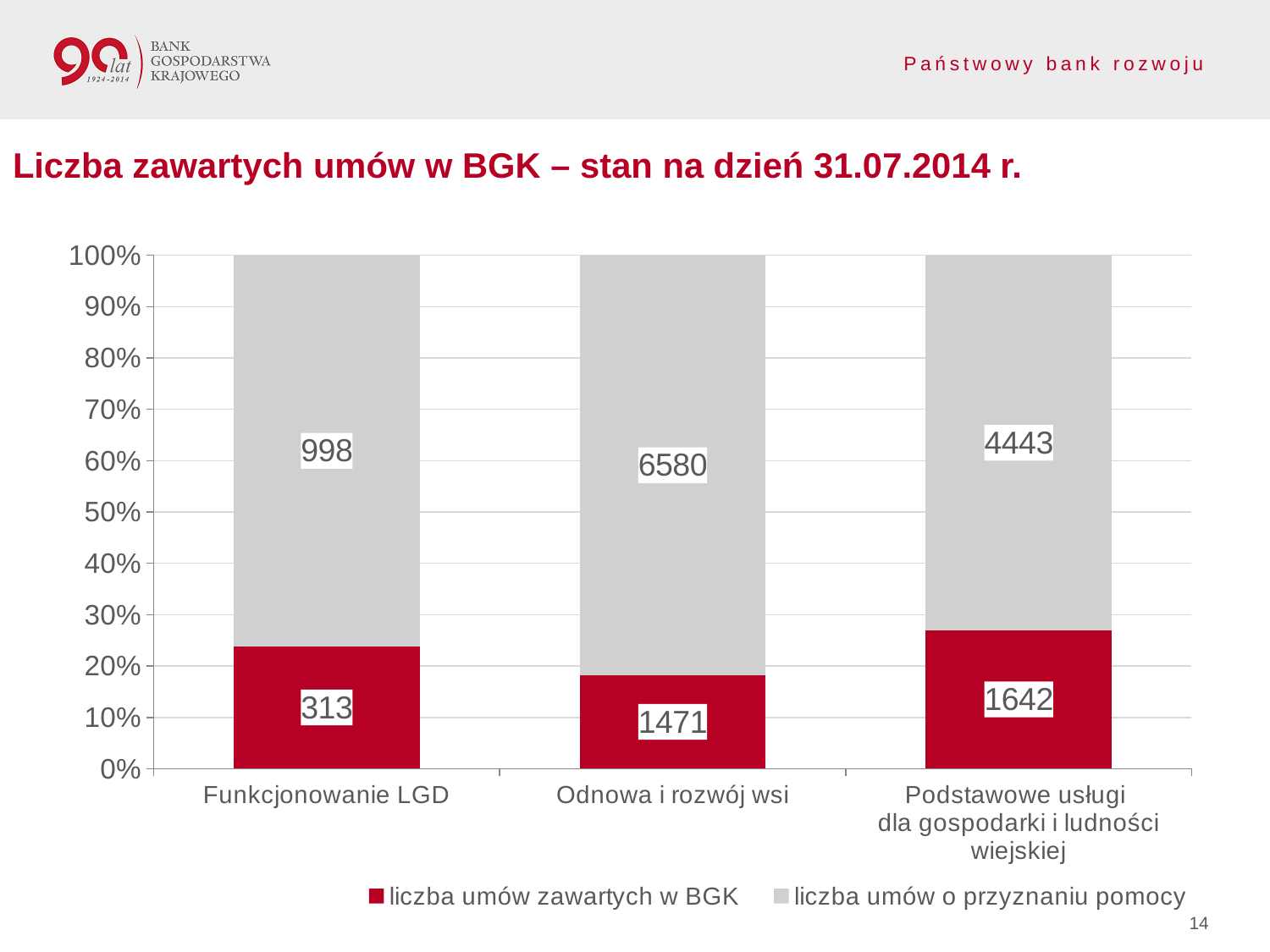
What is the value of 'liczba umów zawartych w BGK' for 'Funkcjonowanie LGD'? 313 How many series does the legend list? 2 What is the value of 'liczba umów zawartych w BGK' for 'Podstawowe usługi dla gospodarki i ludności wiejskiej'? 1642 What type of chart is shown on the slide? bar chart Which is larger: 'liczba umów zawartych w BGK' for 'Odnowa i rozwój wsi' or for 'Podstawowe usługi dla gospodarki i ludności wiejskiej'? Podstawowe usługi dla gospodarki i ludności wiejskiej Which category has the lowest value for 'liczba umów zawartych w BGK'? Funkcjonowanie LGD What is the value of 'liczba umów o przyznaniu pomocy' for 'Odnowa i rozwój wsi'? 6580 What is the difference between 'liczba umów o przyznaniu pomocy' and 'liczba umów zawartych w BGK' for 'Podstawowe usługi dla gospodarki i ludności wiejskiej'? 2801 What is the total of the two values in the 'Funkcjonowanie LGD' bar? 1311 How many categories are shown on the x axis? 3 Which category has the highest value for 'liczba umów o przyznaniu pomocy'? Odnowa i rozwój wsi Is the share of 'liczba umów zawartych w BGK' in the 'Odnowa i rozwój wsi' bar greater or less than 20%? less